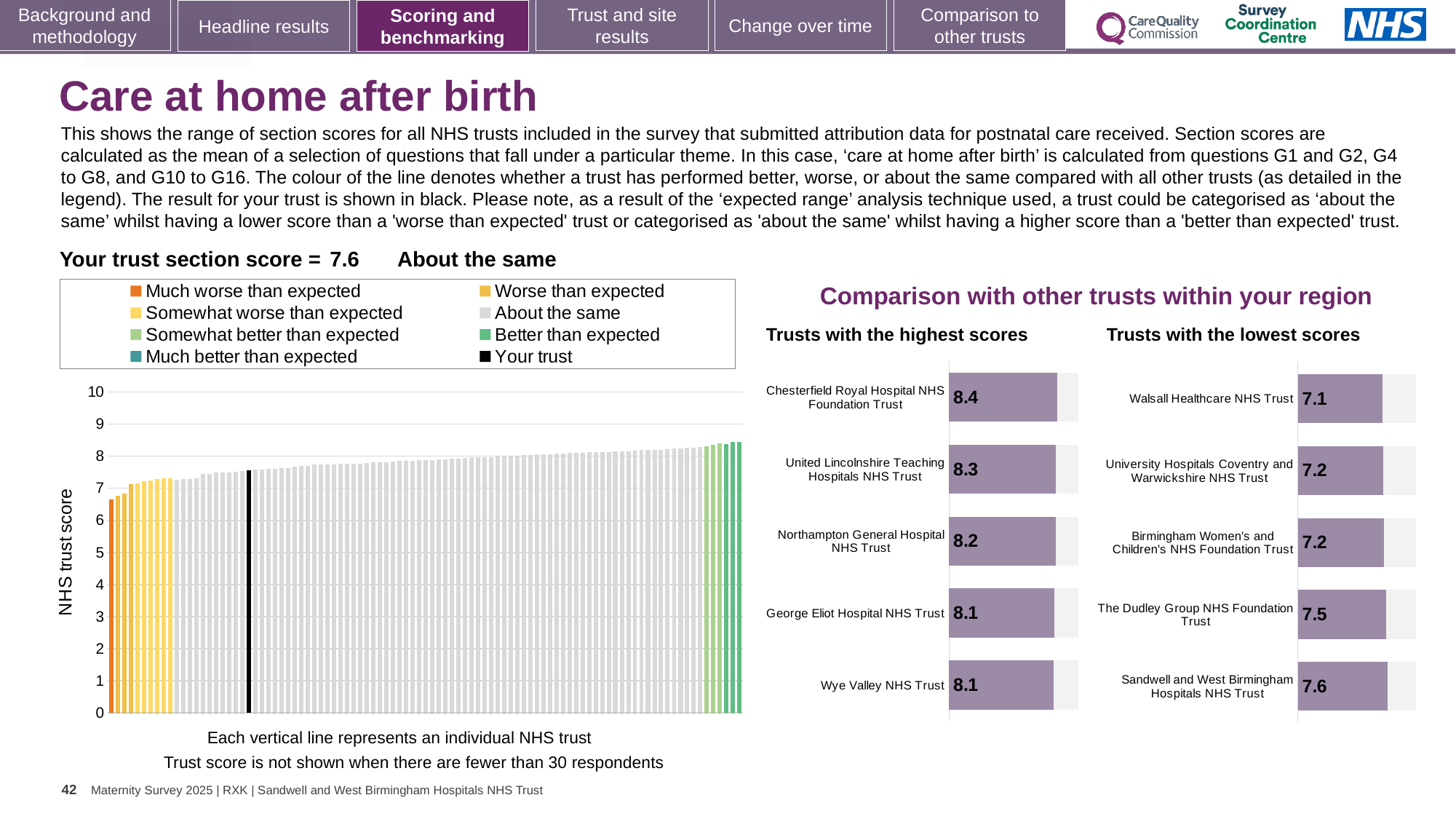
In the 'Trusts with the highest scores' chart, which trust has the highest score? Chesterfield Royal Hospital NHS Foundation Trust In the 'Trusts with the lowest scores' chart, which has the larger score: The Dudley Group NHS Foundation Trust or Walsall Healthcare NHS Trust? The Dudley Group NHS Foundation Trust How many entries does the legend of the main 'NHS trust score' chart list? 8 In the main 'NHS trust score' chart on the left, is the value for the leftmost bar greater or less than 7? less What kind of chart is the 'Trusts with the lowest scores' chart? bar chart In the 'Trusts with the highest scores' chart, what is the score for Chesterfield Royal Hospital NHS Foundation Trust? 8.4 How many trusts are shown in the 'Trusts with the highest scores' chart? 5 In the 'Trusts with the lowest scores' chart, what is the score for Sandwell and West Birmingham Hospitals NHS Trust? 7.6 In the 'Trusts with the highest scores' chart, what is the difference between the scores of Chesterfield Royal Hospital NHS Foundation Trust and Wye Valley NHS Trust? 0.3 In the main 'NHS trust score' chart on the left, do the bar values rise or fall from left to right? rise In the 'Trusts with the lowest scores' chart, which trust has the lowest score? Walsall Healthcare NHS Trust In the 'Trusts with the lowest scores' chart, what is the score for Walsall Healthcare NHS Trust? 7.1